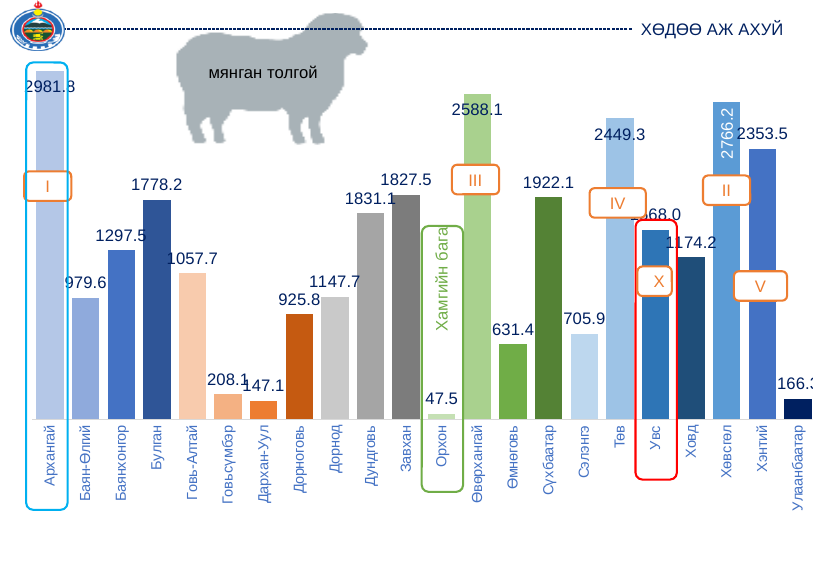
Which category has the highest value? Архангай What is the value for Орхон? 47.5 Which category has the lowest value? Орхон What is the difference between the values for Архангай and Хөвсгөл? 215.1 What is the value for Өвөрхангай? 2588.1 Which is larger, the value for Булган or the value for Сүхбаатар? Сүхбаатар What is the value for Сүхбаатар? 1922.1 What is the value for Хэнтий? 2353.5 What is the value for Архангай? 2981.3 What type of chart is shown on the slide? bar chart How many categories (aimags) are shown in the chart? 22 What unit is stated next to the sheep icon above the chart? мянган толгой